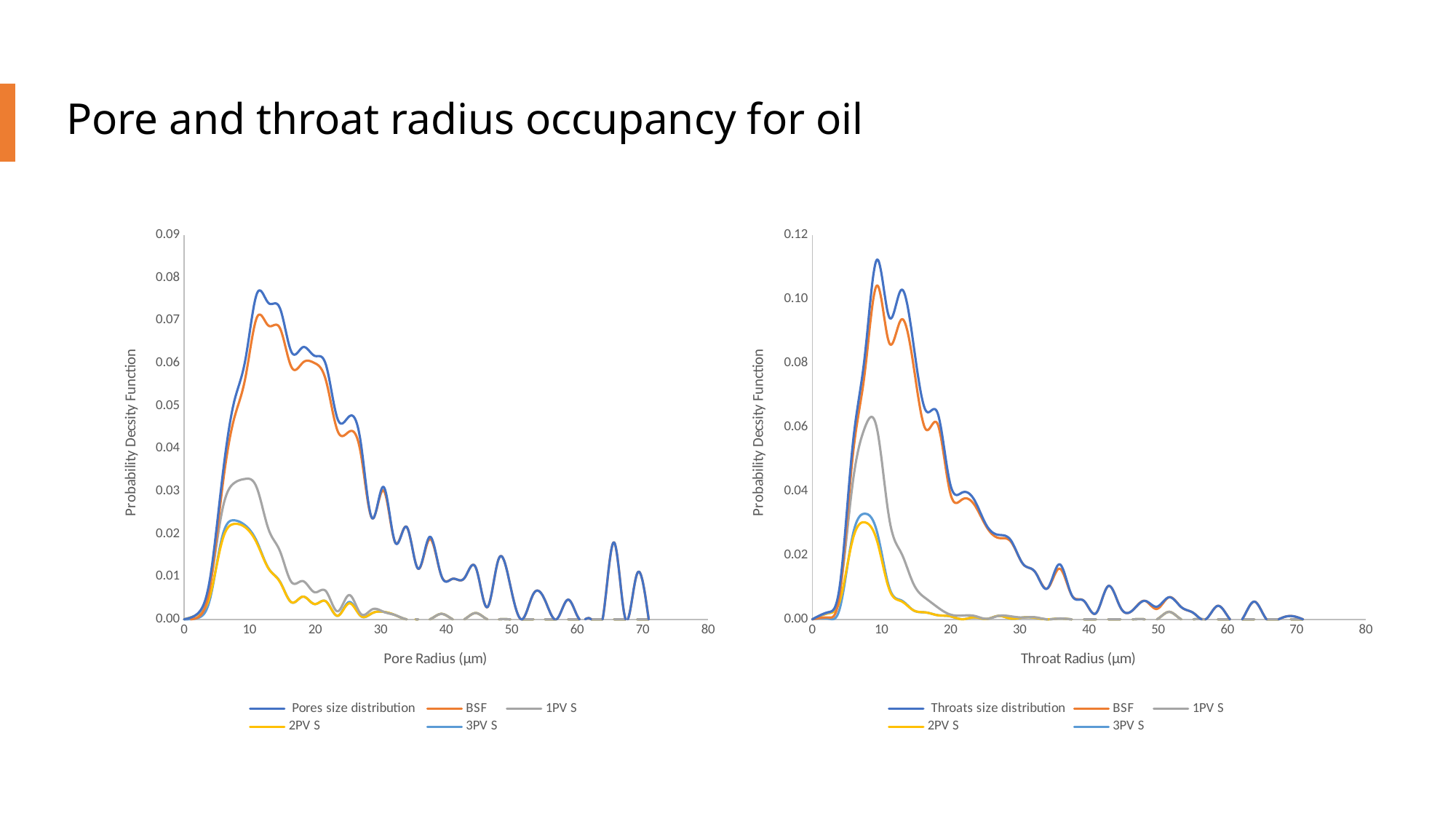
In the left chart (Pore Radius), is the peak value of the Pores size distribution series greater or less than 0.07? greater What is the x-axis label of the right chart? Throat Radius (μm) How many series does the legend of the left chart (Pore Radius) list? 5 In the left chart (Pore Radius), is the peak value of the 1PV S series greater or less than 0.04? less In the right chart (Throat Radius), is the peak value of the Throats size distribution series greater or less than 0.10? greater In the left chart (Pore Radius), which series reaches the highest peak value? Pores size distribution In the left chart (Pore Radius), do the values of the BSF series rise or fall as the pore radius increases from 20 to 40 μm? fall What kind of chart is the left chart, titled with x-axis 'Pore Radius (μm)'? line chart In the right chart (Throat Radius), which series has a higher peak, 1PV S or 2PV S? 1PV S How many series does the legend of the right chart (Throat Radius) list? 5 In the right chart (Throat Radius), which series reaches the highest peak value? Throats size distribution